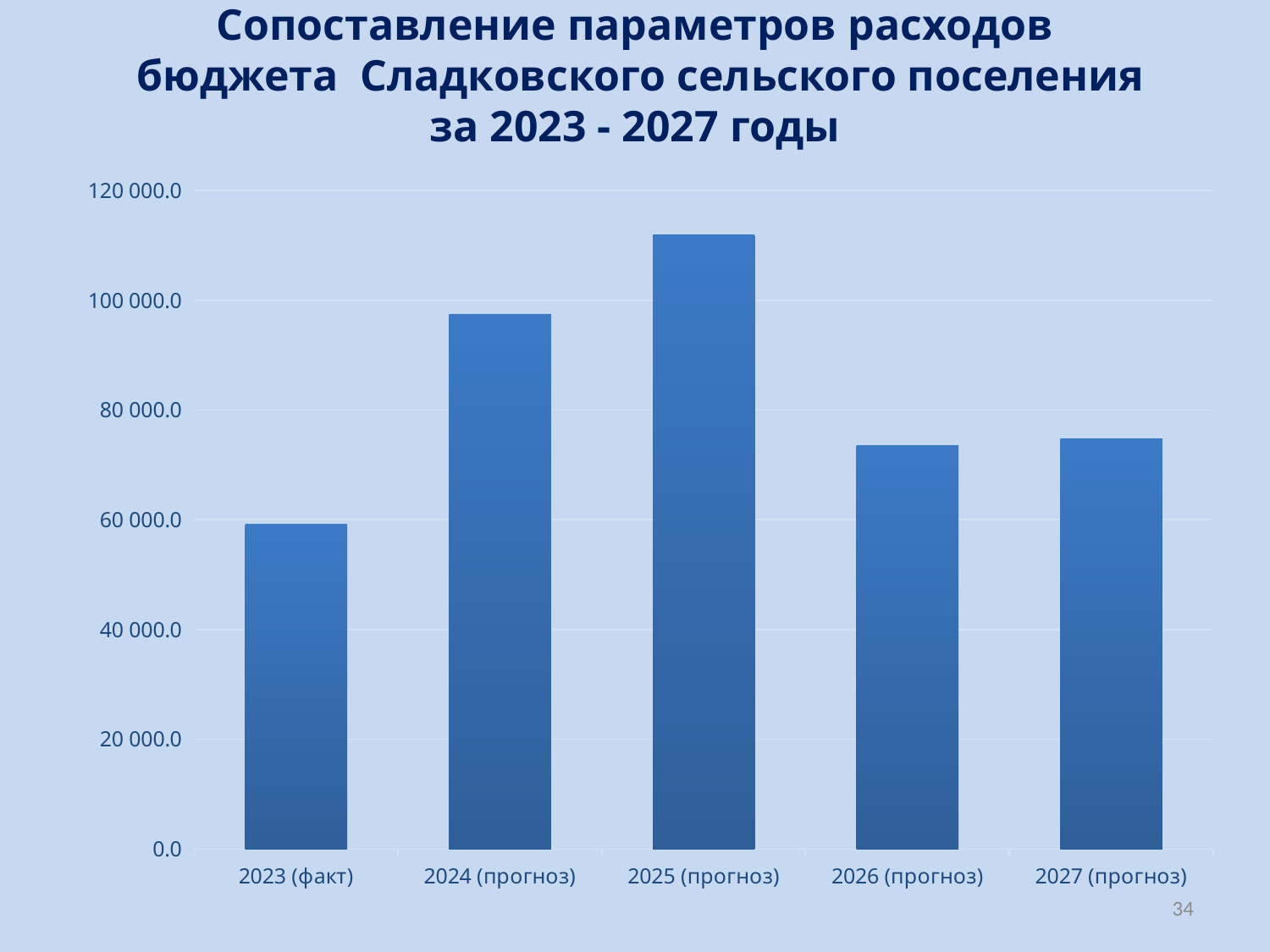
Which is larger, the value for 2024 (прогноз) or the value for 2026 (прогноз)? 2024 (прогноз) Which year has the lowest value? 2023 (факт) Is the value for 2027 (прогноз) greater or less than 60 000.0? greater What is the title of the chart? Сопоставление параметров расходов бюджета Сладковского сельского поселения за 2023 - 2027 годы What kind of chart is shown on the slide? bar chart Is the value for 2025 (прогноз) greater or less than 100 000.0? greater How many categories (years) are shown on the x axis? 5 Do the values rise or fall from 2023 (факт) to 2025 (прогноз)? rise Which year has the highest value? 2025 (прогноз) Is the value for 2026 (прогноз) greater or less than 80 000.0? less